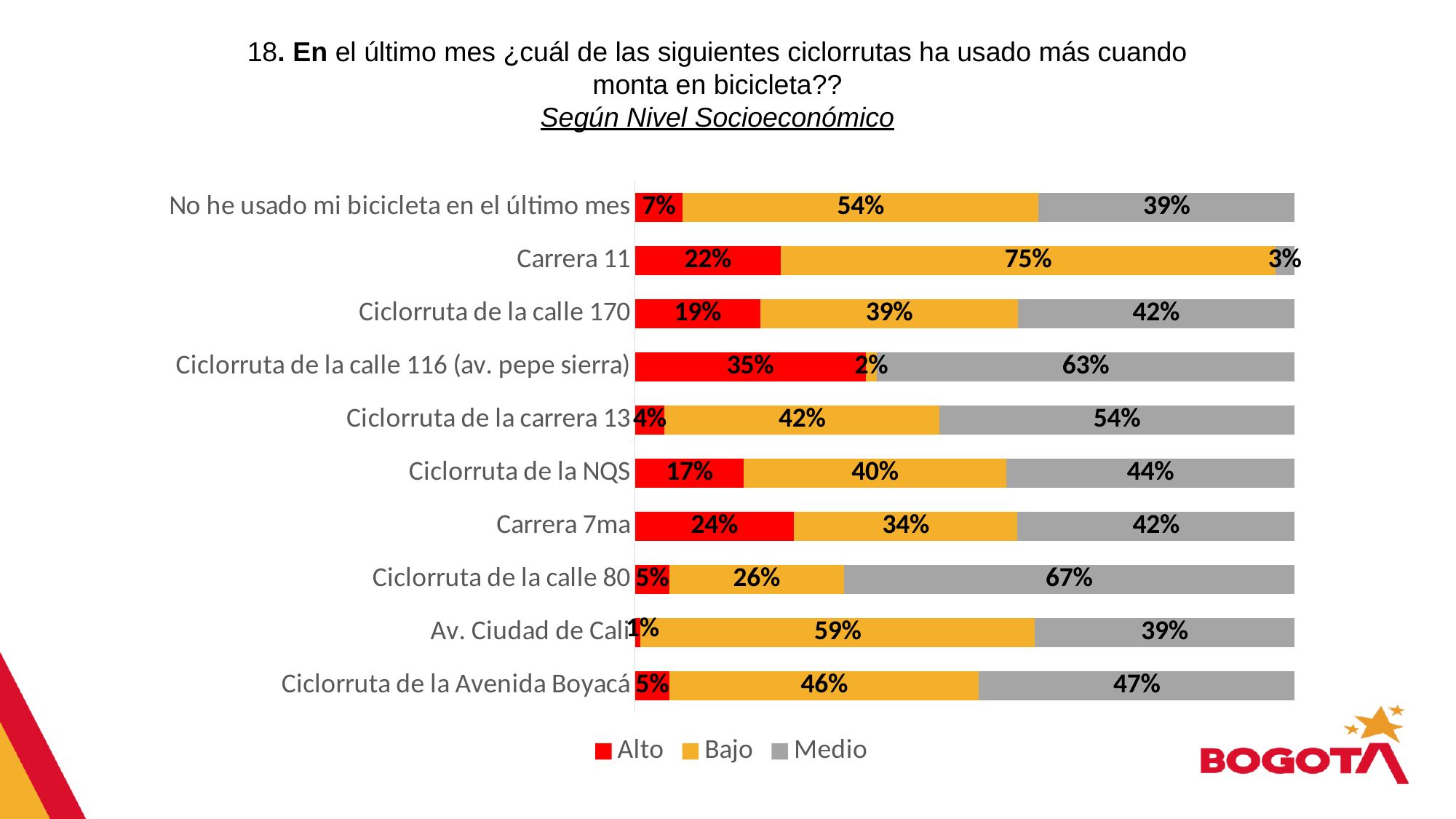
What kind of chart is shown on the slide? Stacked bar chart How many categories (ciclorrutas/options) are shown in the chart? 10 What is the Alto value for Ciclorruta de la calle 116 (av. pepe sierra)? 35% How many series does the legend list? 3 What is the difference between the Medio value for Ciclorruta de la calle 80 and the Medio value for Ciclorruta de la calle 170? 25 percentage points Which category has the highest Alto value? Ciclorruta de la calle 116 (av. pepe sierra) Which is larger: the Bajo value for Av. Ciudad de Cali or the Bajo value for Ciclorruta de la Avenida Boyacá? Av. Ciudad de Cali Which category has the lowest Medio value? Carrera 11 Which colour represents the Medio series in the legend? Grey Which category has the lowest Alto value? Av. Ciudad de Cali What is the Bajo value for Carrera 11? 75% What is the Medio value for Ciclorruta de la calle 80? 67%